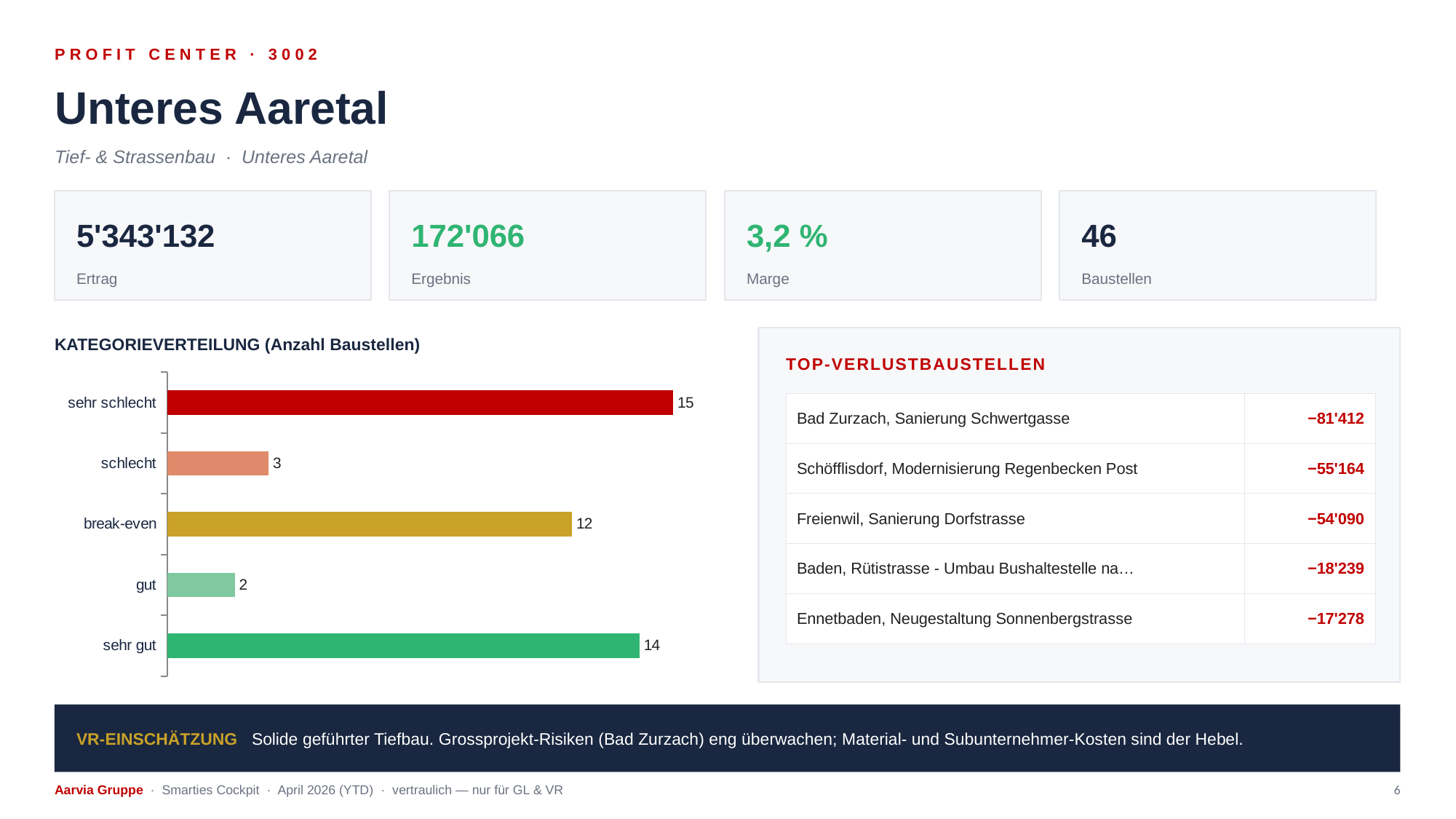
How many categories are shown in the Kategorieverteilung chart? 5 Which category has the lowest number of Baustellen in the Kategorieverteilung chart? gut Which category has the highest number of Baustellen in the Kategorieverteilung chart? sehr schlecht What is the value for "gut" in the Kategorieverteilung chart? 2 What is the value for "sehr schlecht" in the Kategorieverteilung chart? 15 What is the difference between the values for "sehr schlecht" and "sehr gut" in the Kategorieverteilung chart? 1 What is the total number of Baustellen across all categories in the Kategorieverteilung chart? 46 What kind of chart is the Kategorieverteilung chart? bar chart What is the difference between the values for "break-even" and "schlecht" in the Kategorieverteilung chart? 9 What colour is the bar for "sehr gut" in the Kategorieverteilung chart? green What is the value for "break-even" in the Kategorieverteilung chart? 12 Which is larger in the Kategorieverteilung chart, the value for "schlecht" or the value for "gut"? schlecht